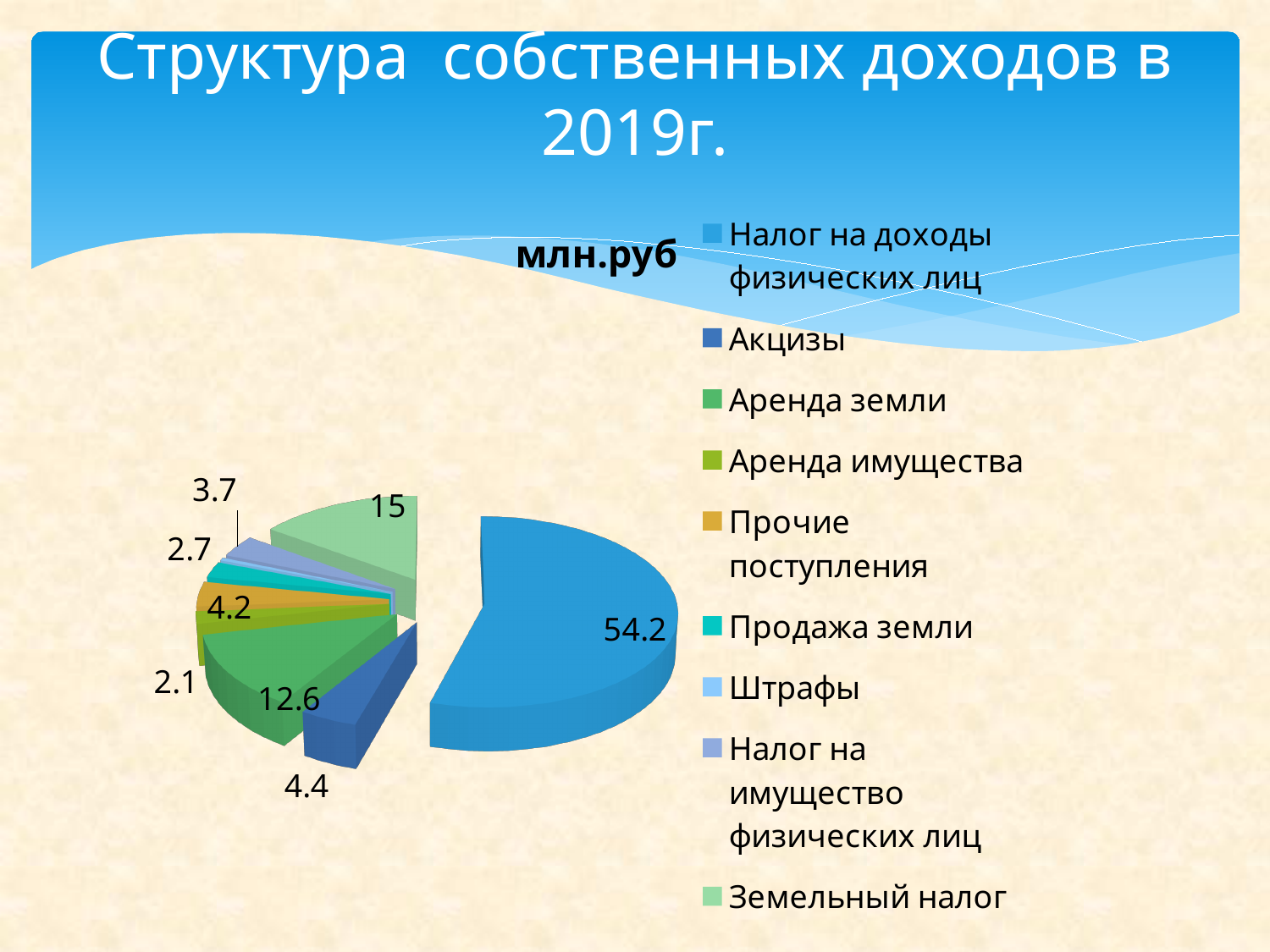
Which is larger in the pie chart: Аренда земли or Земельный налог? Земельный налог What is the value for Аренда земли in the pie chart? 12.6 What is the title shown above the pie chart? млн.руб Which category has the largest slice in the pie chart? Налог на доходы физических лиц What is the value for Налог на доходы физических лиц in the pie chart? 54.2 What is the value for Акцизы in the pie chart? 4.4 What is the value for Аренда имущества in the pie chart? 2.1 How many entries does the legend of the pie chart list? 9 What is the value for Прочие поступления in the pie chart? 4.2 What kind of chart is shown on the slide? pie chart What is the difference between the values for Налог на доходы физических лиц and Земельный налог? 39.2 What is the value for Земельный налог in the pie chart? 15